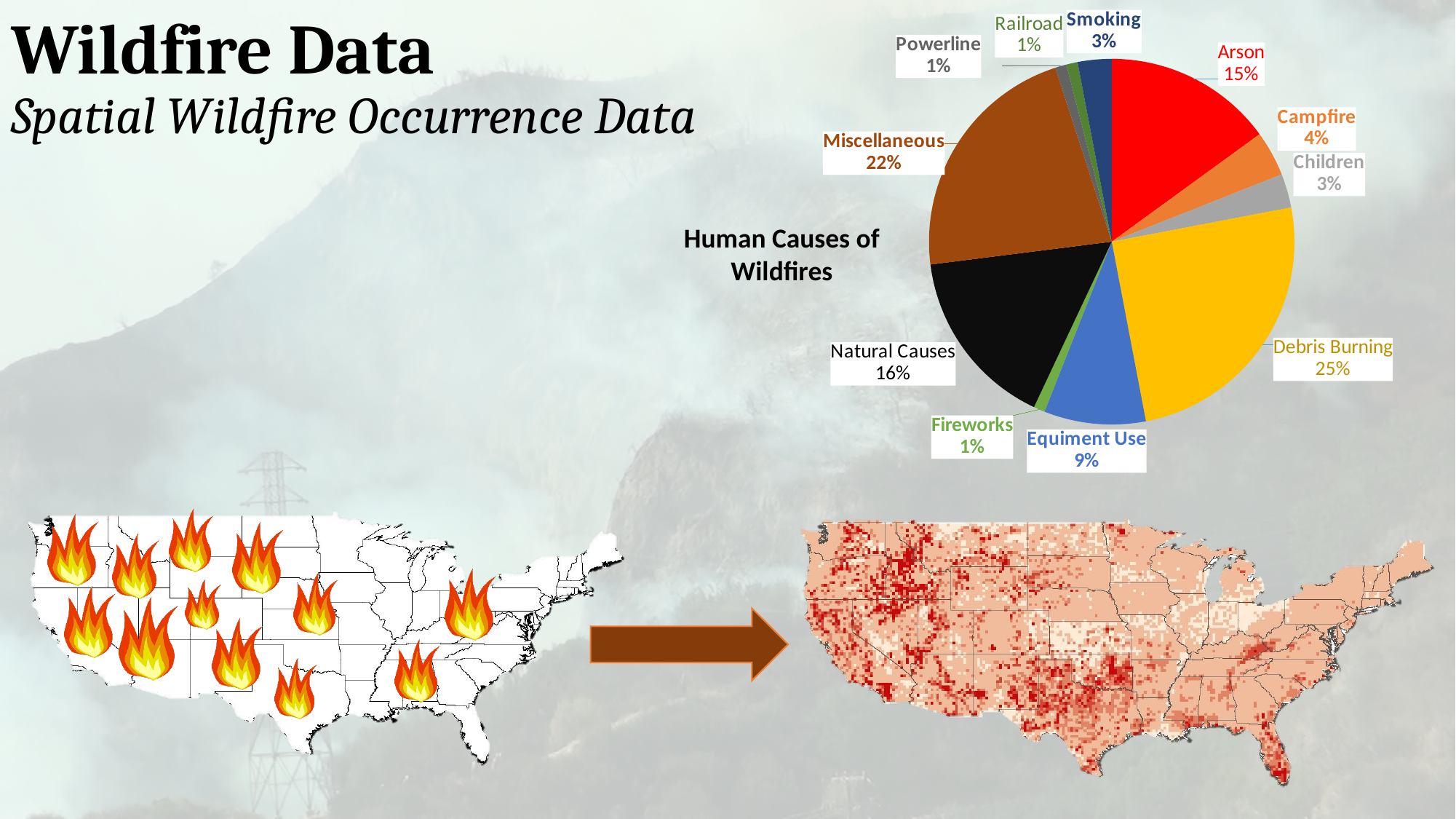
Which is larger, the share for Campfire or the share for Children? Campfire What share of wildfires is attributed to Arson? 15% What kind of chart is shown on the slide? Pie chart What share of wildfires is attributed to Natural Causes? 16% What share of wildfires is attributed to Equipment Use? 9% How many categories are shown in the pie chart? 11 What share of wildfires is attributed to Debris Burning? 25% What colour is the Debris Burning slice? Yellow What is the title of the pie chart? Human Causes of Wildfires Which cause has the largest share of the pie? Debris Burning What is the combined share of Debris Burning and Miscellaneous? 47% What is the difference between the Miscellaneous share and the Arson share? 7%